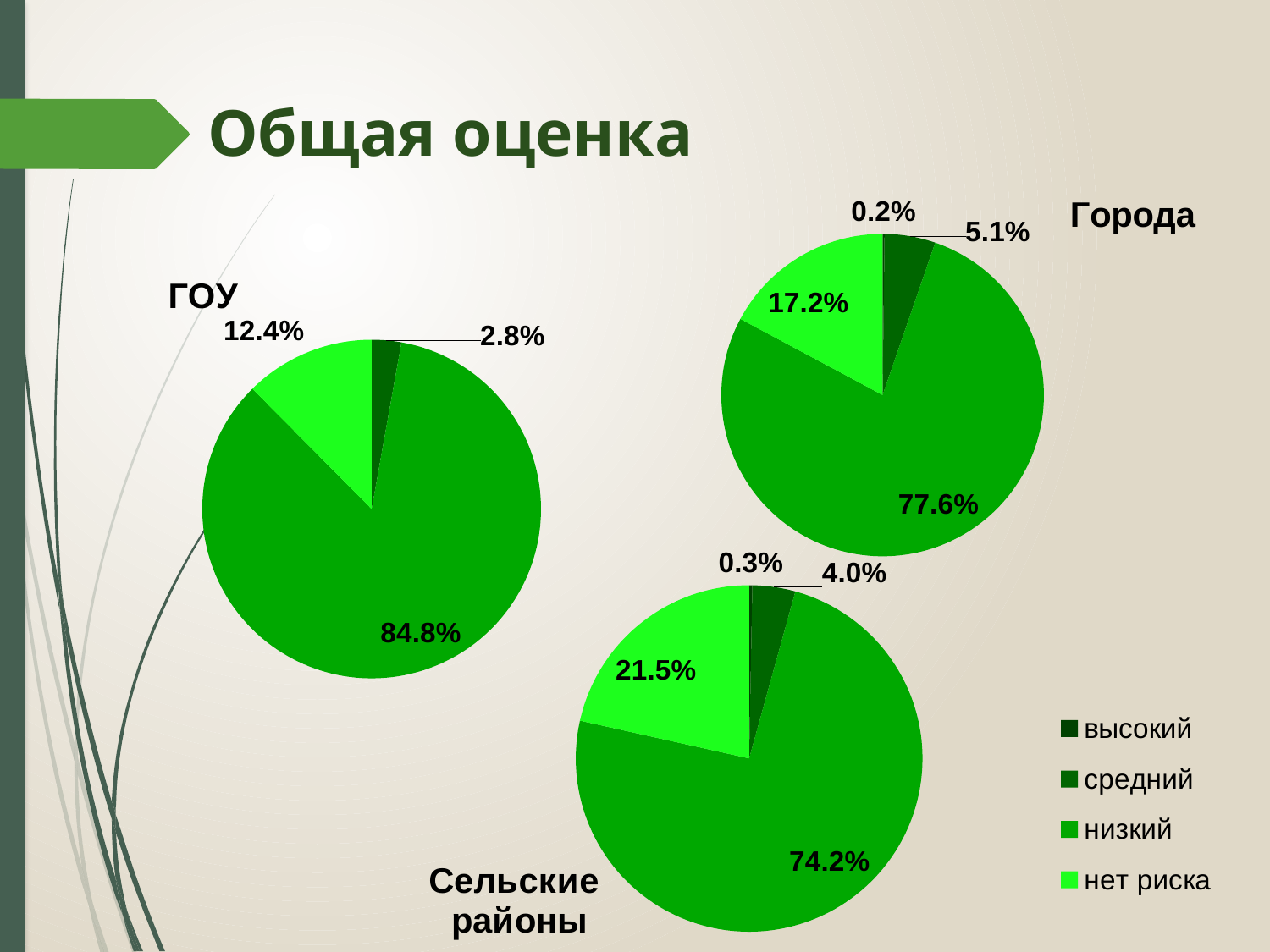
In the Сельские районы pie chart, what is the share of the нет риска category? 21.5% In the ГОУ pie chart, what is the share of the низкий category? 84.8% In the ГОУ pie chart, what is the share of the нет риска category? 12.4% What kind of charts are shown on the slide? Pie charts How many categories does the legend list? 4 Which chart has the larger низкий share, ГОУ or Сельские районы? ГОУ What is the difference between the нет риска share in the Сельские районы chart and in the Города chart? 4.3% In the Сельские районы pie chart, which category has the largest share? низкий In the Города pie chart, what is the share of the высокий category? 0.2% How many pie charts are on the slide? 3 In the Города pie chart, what is the share of the средний category? 5.1% In the Города pie chart, which category has the smallest share? высокий